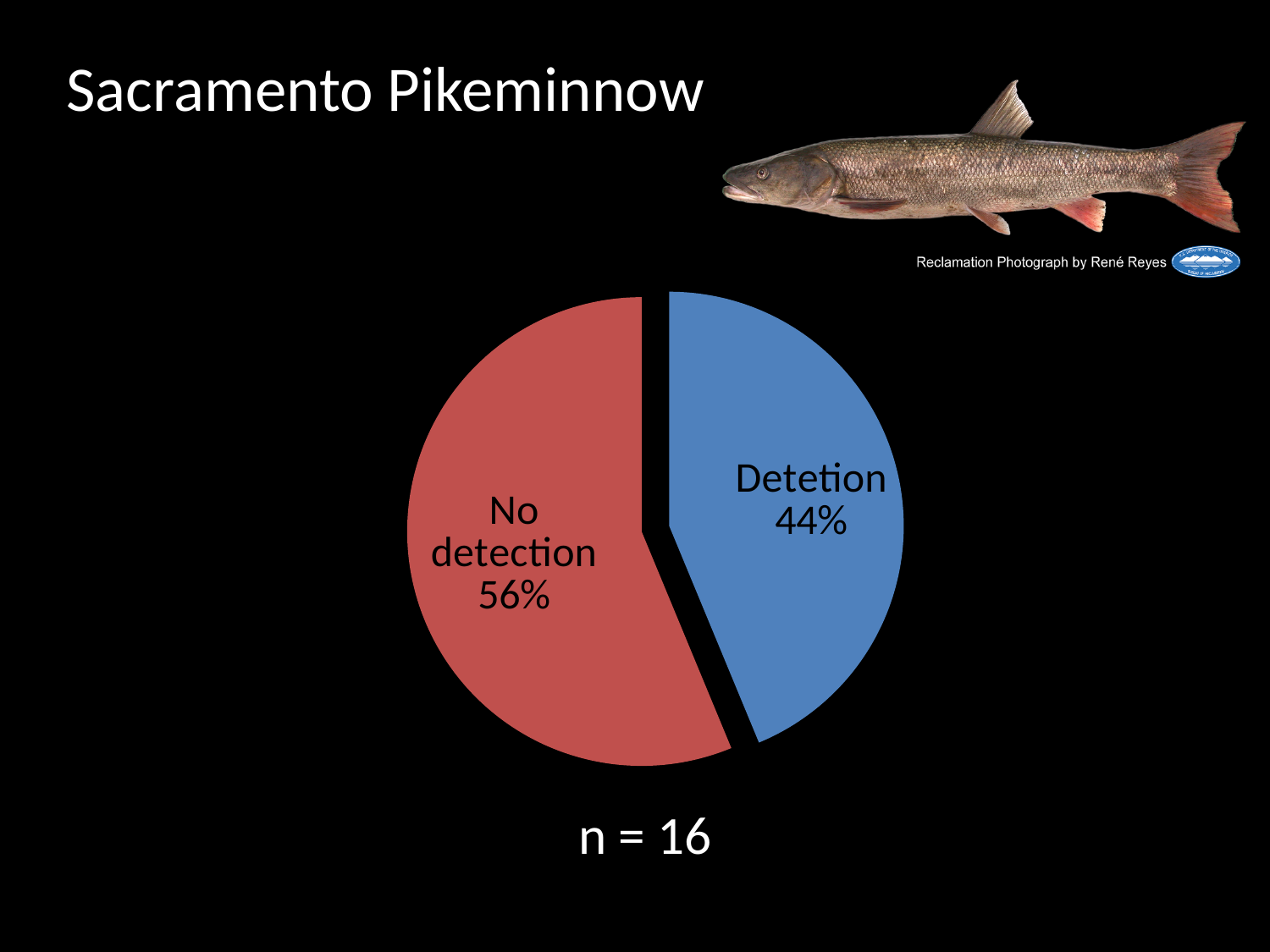
What kind of chart is shown on the slide? pie chart What colour is the "No detection" slice of the pie? red Which is larger, the "Detetion" slice or the "No detection" slice? No detection Which slice of the pie is the largest? No detection What share of the pie is labelled "No detection"? 56% What is the difference in percentage points between the "No detection" slice and the "Detetion" slice? 12 Is the share for "Detetion" greater or less than 50%? less What sample size is stated below the pie chart? n = 16 Which slice of the pie is the smallest? Detetion How many slices does the pie chart have? 2 What share of the pie is labelled "Detetion"? 44%